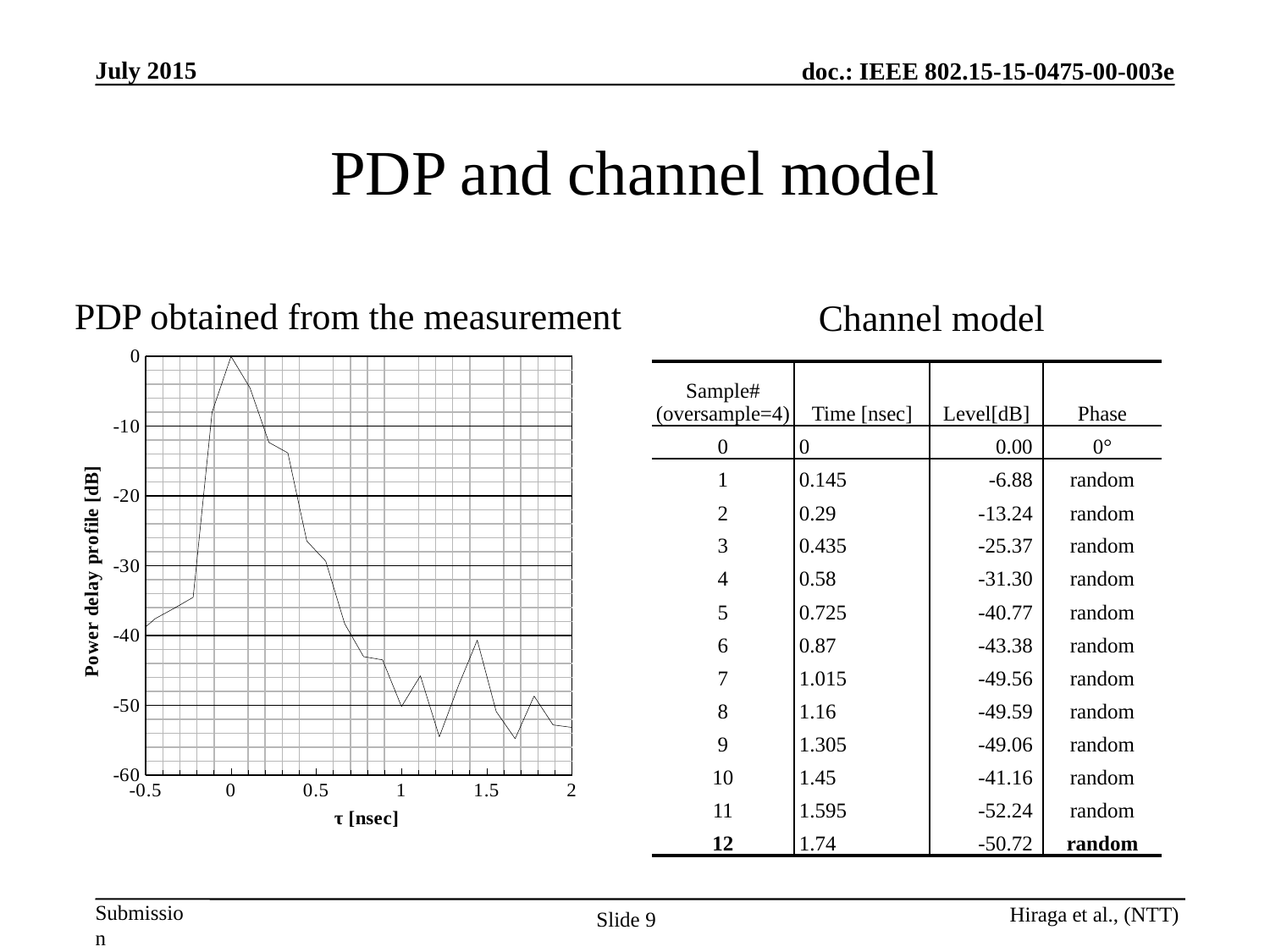
What is the peak value of the power delay profile at τ = 0 nsec? 0 What kind of chart is shown on the slide? line chart Is the power delay profile at τ = 0.25 nsec greater or less than -20 dB? greater What is the label of the y axis of the chart? Power delay profile [dB] What is the label of the x axis of the chart? τ [nsec] Is the power delay profile at τ = -0.5 nsec greater or less than -30 dB? less At which value of τ does the power delay profile reach its highest value? 0 Does the power delay profile generally rise or fall as τ increases from 0 to 2 nsec? fall Which is larger, the power delay profile at τ = 0.25 nsec or at τ = 1 nsec? τ = 0.25 nsec Is the power delay profile at τ = 2 nsec greater or less than -50 dB? less